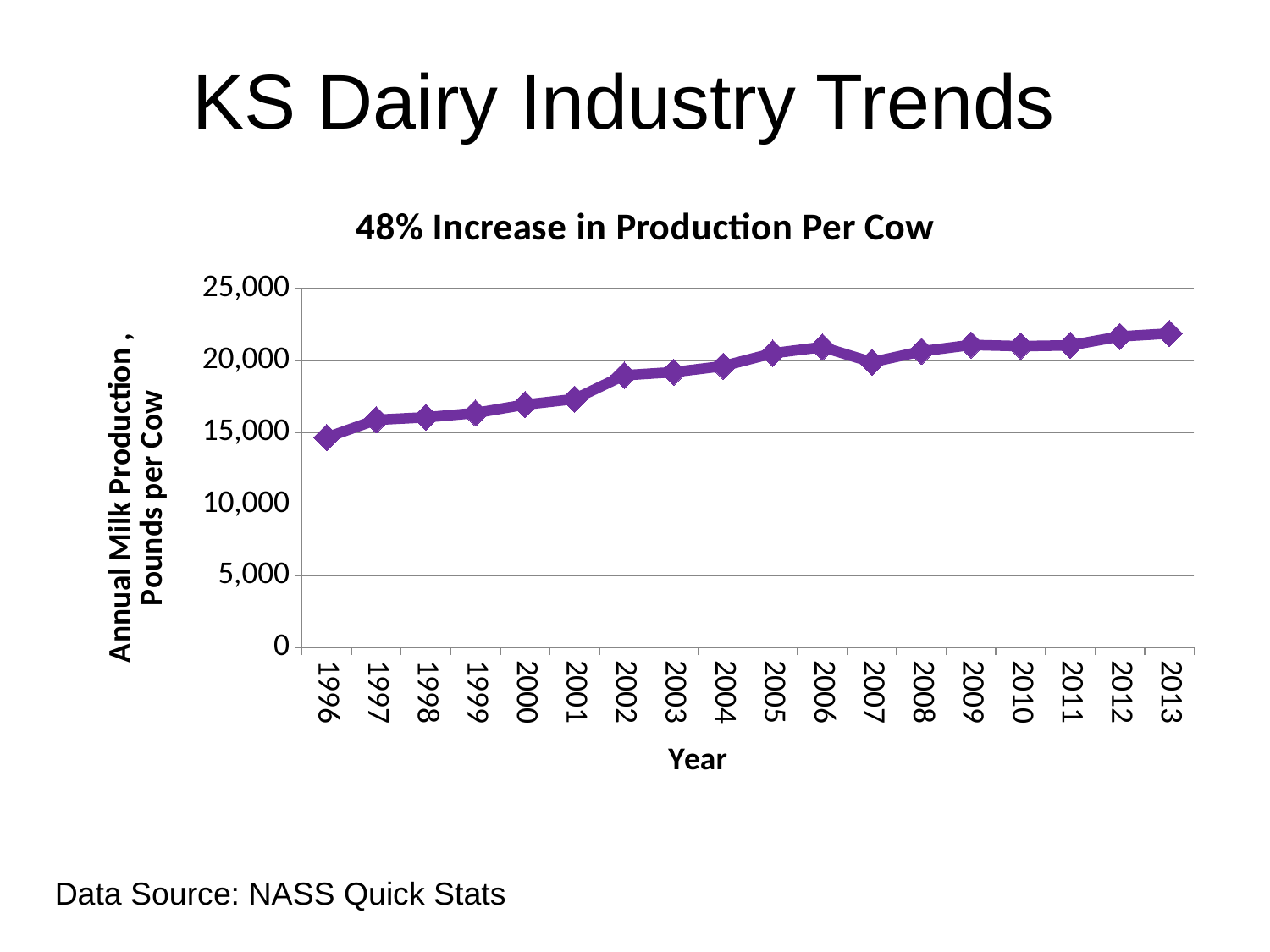
Is the value for 2001 greater or less than 20,000? less What kind of chart is shown on the slide? line chart Is the value for 2013 greater or less than 20,000? greater How many years are plotted on the x axis of the chart? 18 Which year has the higher value, 2001 or 2002? 2002 What is the label on the vertical axis of the chart? Annual Milk Production , Pounds per Cow Overall, do the values rise or fall from 1996 to 2013? rise Is the value for 2006 greater or less than 20,000? greater Which year has the higher value, 2006 or 2007? 2006 What is the title of the chart? 48% Increase in Production Per Cow Which year has the lowest annual milk production per cow? 1996